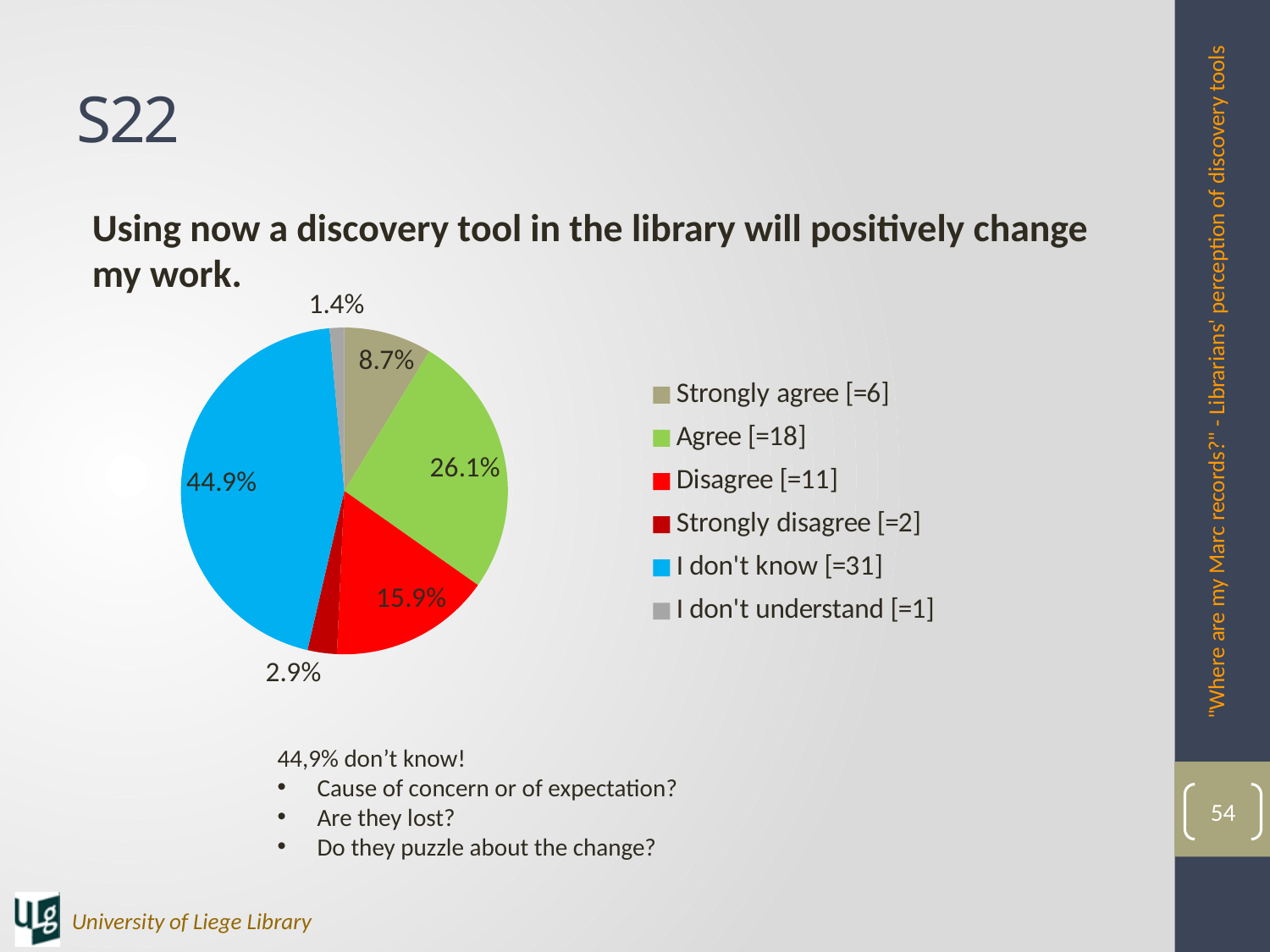
According to the legend, how many respondents answered "I don't know"? 31 What kind of chart is shown on the slide? pie chart Which category has the smallest share of the pie? I don't understand What percentage of the pie is the "Strongly agree" slice? 8.7% Which slice is larger, "Agree" or "Disagree"? Agree What percentage of the pie is the "Strongly disagree" slice? 2.9% What percentage of the pie is the "Disagree" slice? 15.9% What percentage of the pie is the "Agree" slice? 26.1% What is the difference in percentage points between the "Agree" and "Strongly agree" slices? 17.4 Which category has the largest share of the pie? I don't know What percentage of the pie is the "I don't know" slice? 44.9% How many categories does the legend list? 6